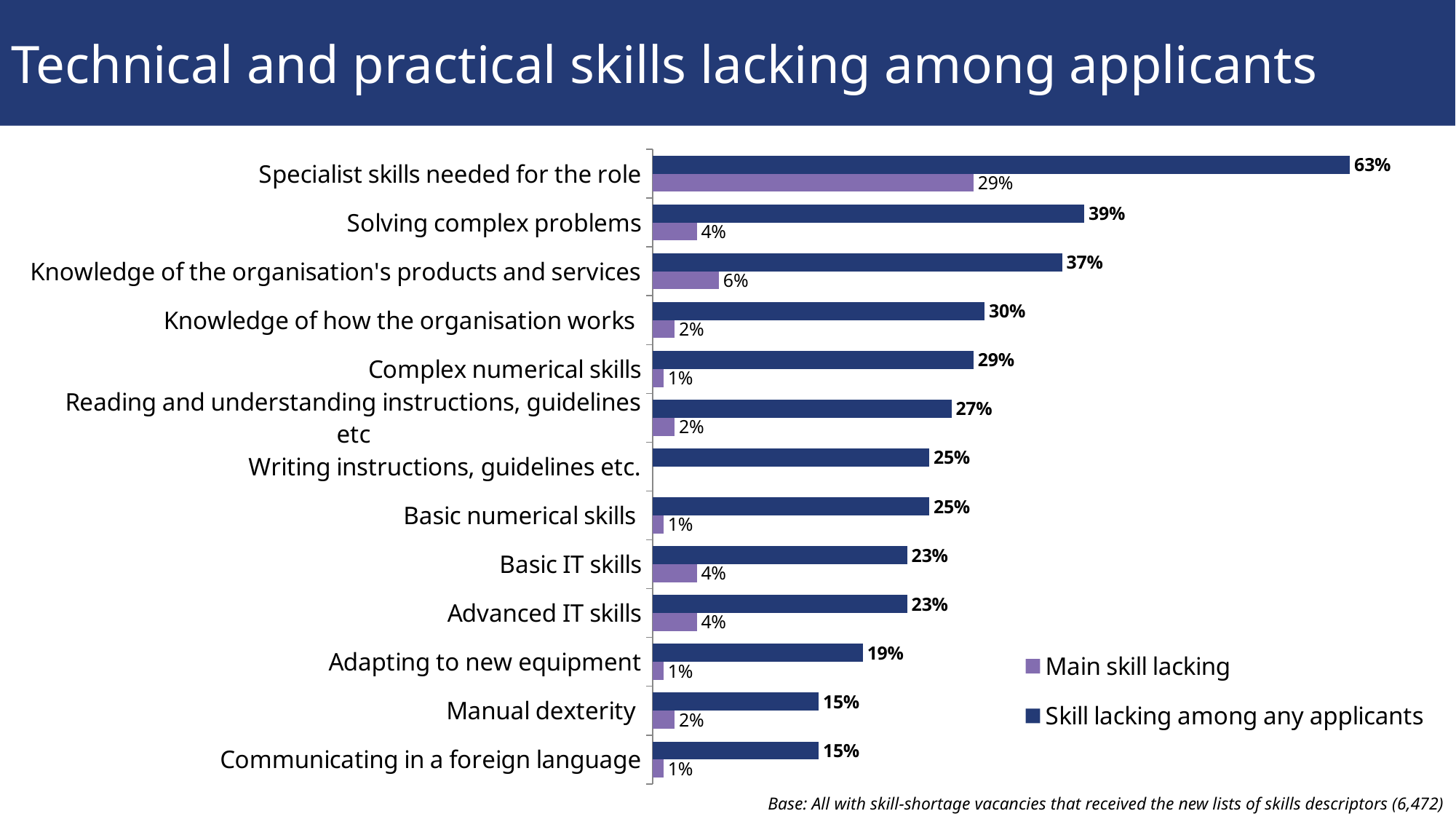
What is the difference between the 'Skill lacking among any applicants' values for Specialist skills needed for the role and Solving complex problems? 24% Which has a larger 'Skill lacking among any applicants' value: Knowledge of how the organisation works or Adapting to new equipment? Knowledge of how the organisation works What is the 'Main skill lacking' value for Manual dexterity? 2% How many series does the legend list? 2 What type of chart is shown on the slide? Bar chart What is the 'Skill lacking among any applicants' value for Knowledge of the organisation's products and services? 37% Which skill has the highest 'Main skill lacking' value? Specialist skills needed for the role What is the 'Main skill lacking' value for Solving complex problems? 4% How many skill categories are shown on the chart? 13 Which colour represents 'Main skill lacking' in the legend? Purple Which skill has the highest 'Skill lacking among any applicants' value? Specialist skills needed for the role What percentage of employers reported specialist skills needed for the role as a skill lacking among any applicants? 63%